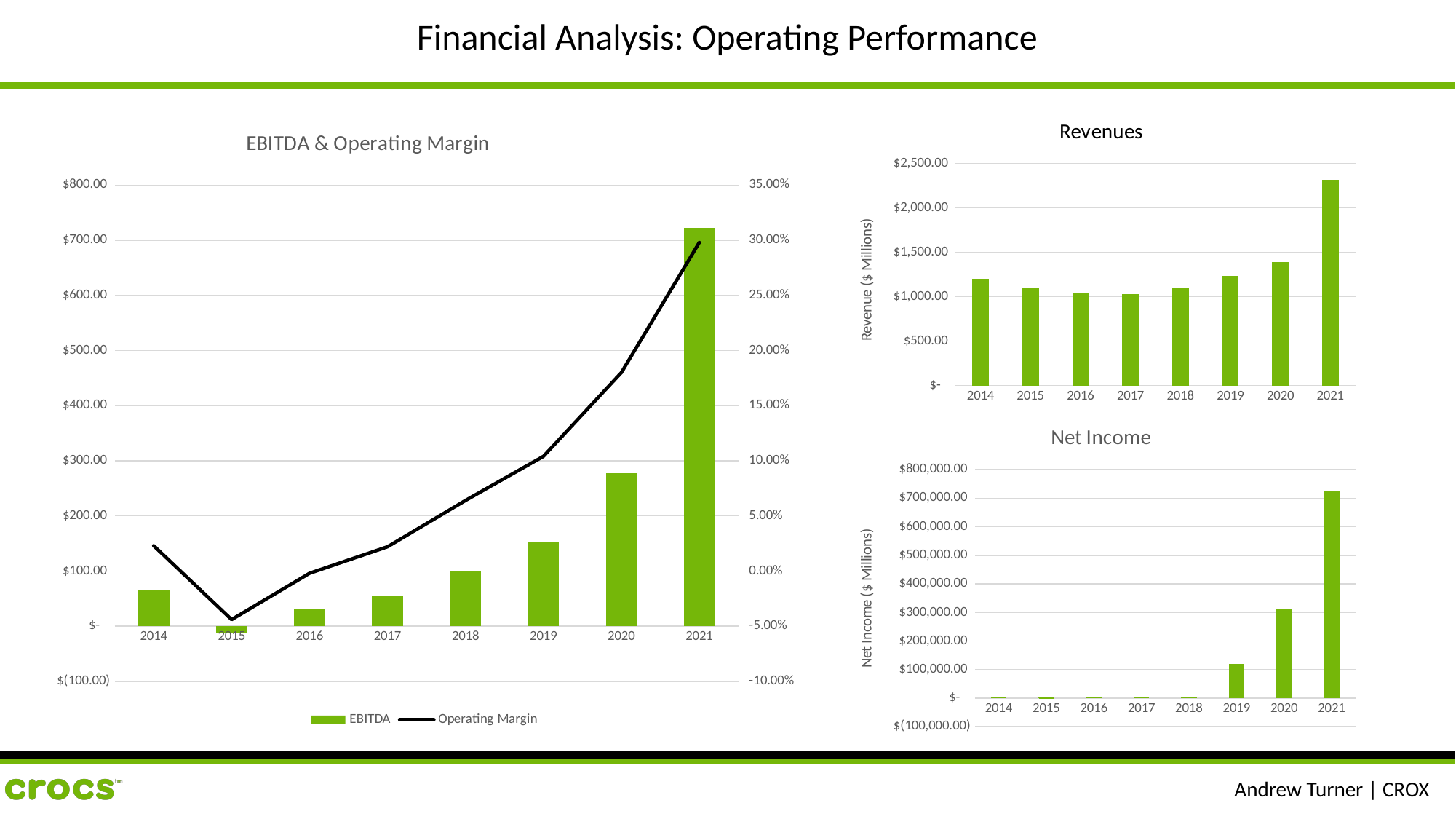
What kind of chart is the Revenues chart? bar chart In the EBITDA & Operating Margin chart, which year has the lowest EBITDA? 2015 How many series does the legend of the EBITDA & Operating Margin chart list? 2 In the Revenues chart, which year has the highest revenue? 2021 In the Net Income chart, is the value for 2021 greater or less than $600,000.00? greater In the Revenues chart, is the value for 2021 greater or less than $2,000.00? greater In the EBITDA & Operating Margin chart, is the Operating Margin for 2015 greater or less than 0.00%? less In the EBITDA & Operating Margin chart, which year has the highest EBITDA? 2021 In the Revenues chart, which is larger, the revenue for 2019 or for 2020? 2020 In the EBITDA & Operating Margin chart, does the Operating Margin rise or fall from 2015 to 2021? rise